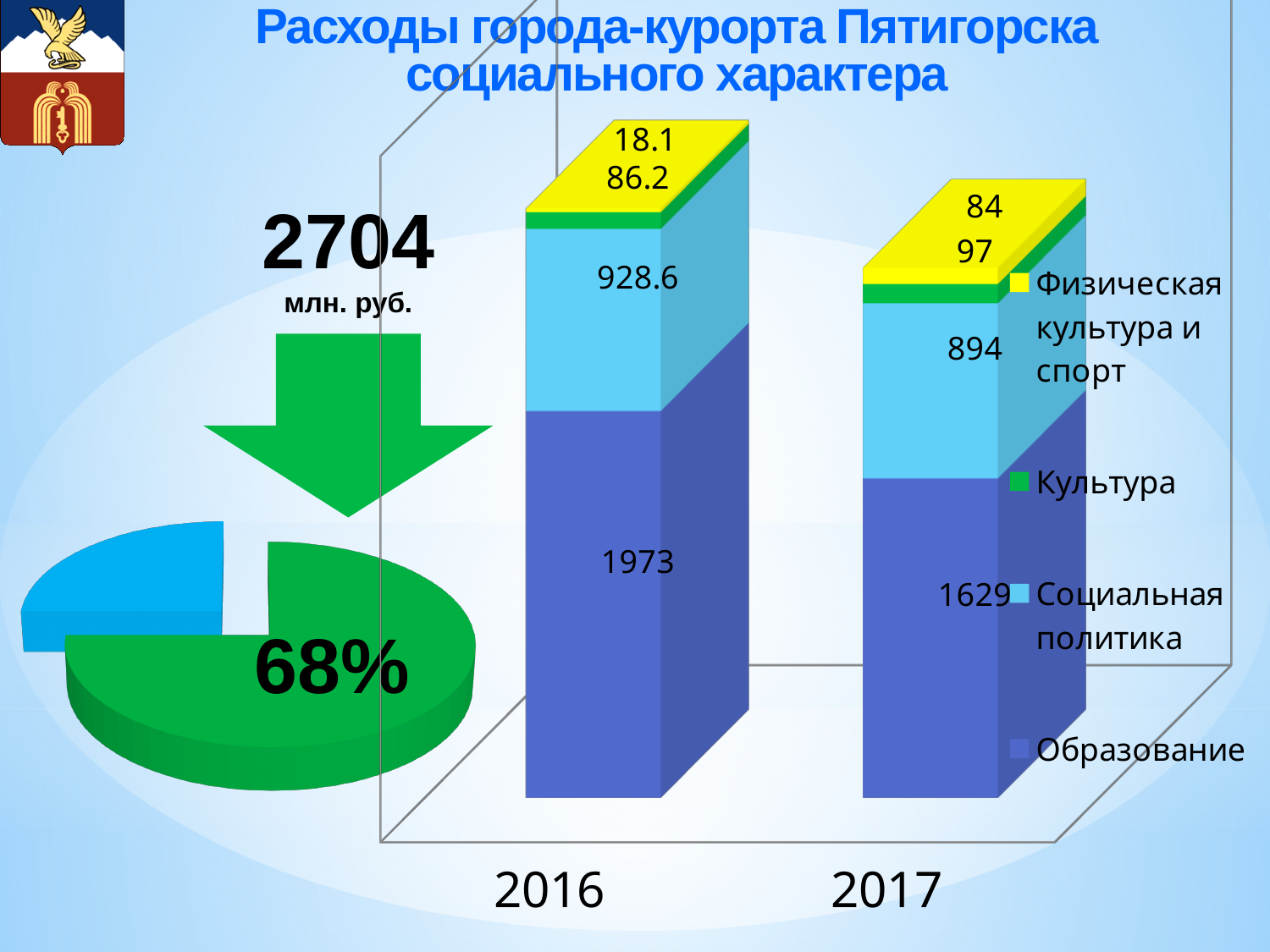
How many series does the legend of the stacked bar chart list? 4 In the stacked bar chart, what is the difference between the Образование values for 2016 and 2017? 344 What kind of chart is the chart on the right of the slide? stacked bar chart In the pie chart on the left, what share is shown for the green slice? 68% In the stacked bar chart, what is the difference between the Социальная политика values for 2016 and 2017? 34.6 In the stacked bar chart, which year has the larger value for Образование, 2016 or 2017? 2016 In the stacked bar chart, what is the value for Образование in 2017? 1629 In the stacked bar chart, what is the value for Социальная политика in 2017? 894 In the stacked bar chart, what is the total of the 2017 bar? 2704 In the stacked bar chart, what is the value for Образование in 2016? 1973 In the stacked bar chart, what is the value for Социальная политика in 2016? 928.6 How many years are shown on the x axis of the stacked bar chart? 2